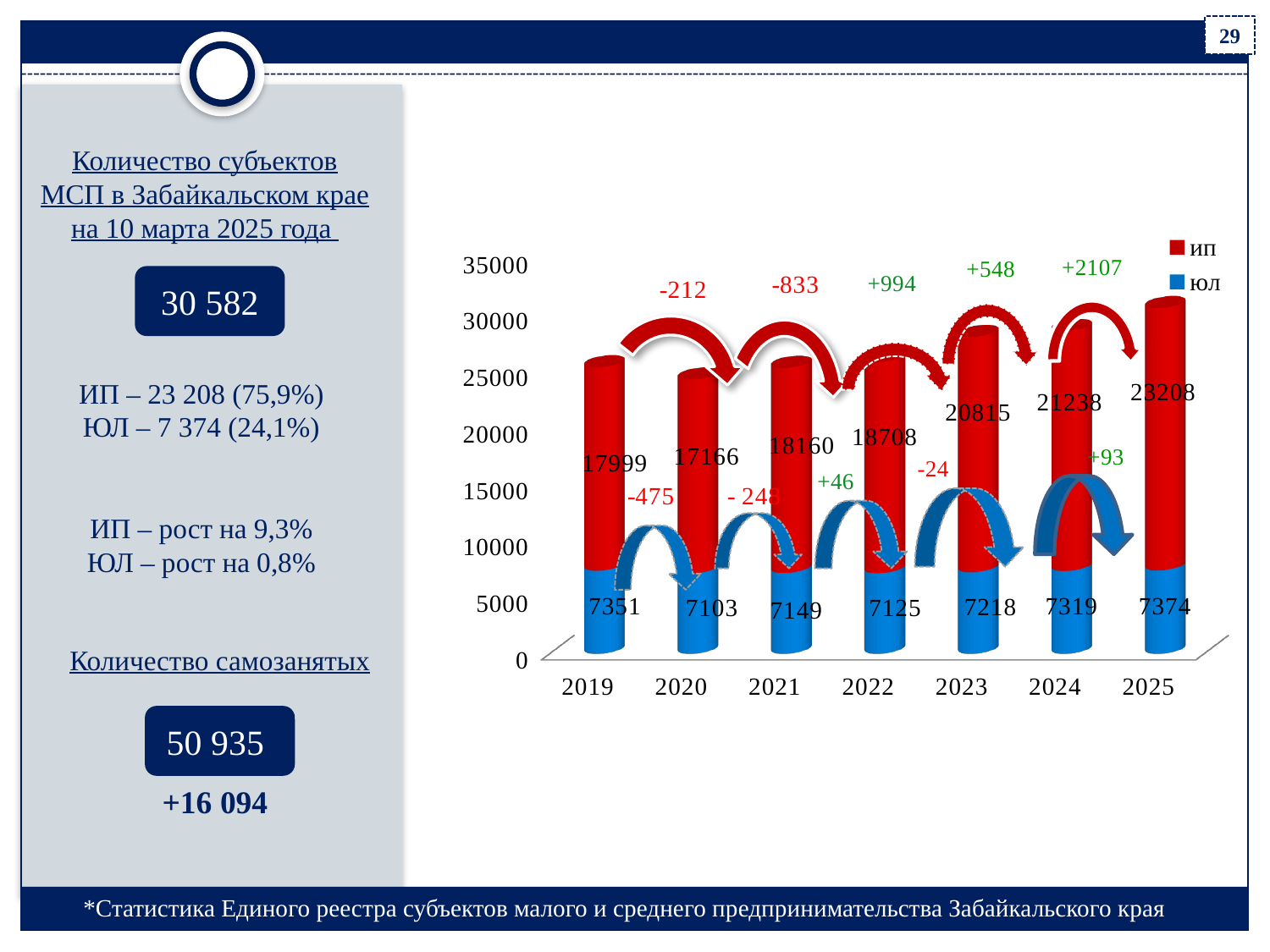
How many series does the legend list? 2 What is the difference between the ЮЛ values for 2019 and 2020? 248 What is the value of ИП for 2023? 20815 What kind of chart is shown? Stacked bar chart In which year is the ИП value the lowest? 2020 Which is larger, the ИП value for 2021 or for 2022? 2022 How many years are shown on the x axis? 7 What is the value of ЮЛ for 2019? 7351 What is the value of ИП for 2025? 23208 In which year is the ЮЛ value the highest? 2025 Which series is shown in red in the legend? ИП What is the total of the stacked bar for 2025 (ИП plus ЮЛ)? 30582